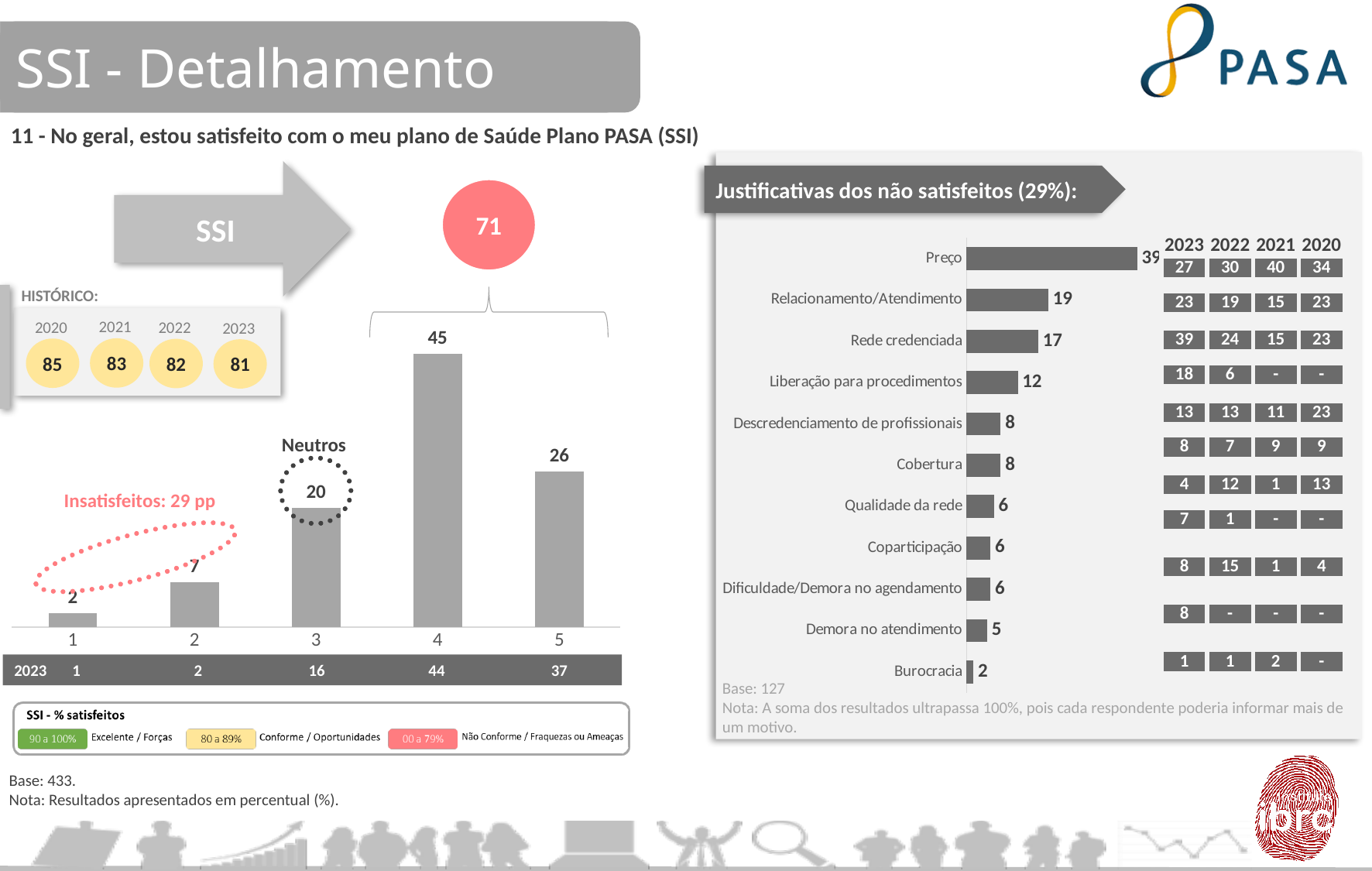
In the 'Justificativas dos não satisfeitos (29%)' chart, what is the value for Liberação para procedimentos? 12 In the left bar chart (SSI distribution), how many categories are shown on the x axis? 5 In the left bar chart (SSI distribution), what is the value for category 1? 2 In the left bar chart (SSI distribution), which category has the highest value? 4 In the 'Justificativas dos não satisfeitos (29%)' chart, which category has the lowest value? Burocracia In the 'Justificativas dos não satisfeitos (29%)' chart, what is the value for Preço? 39 In the 'Justificativas dos não satisfeitos (29%)' chart, how many categories are listed? 11 In the left bar chart (SSI distribution), what is the value for category 4? 45 In the 'Justificativas dos não satisfeitos (29%)' chart, which is larger: Relacionamento/Atendimento or Rede credenciada? Relacionamento/Atendimento In the 'Justificativas dos não satisfeitos (29%)' chart, what is the difference between Preço and Relacionamento/Atendimento? 20 In the left bar chart (SSI distribution), what is the difference between the values for categories 4 and 5? 19 What type of chart is the 'Justificativas dos não satisfeitos (29%)' chart? Bar chart